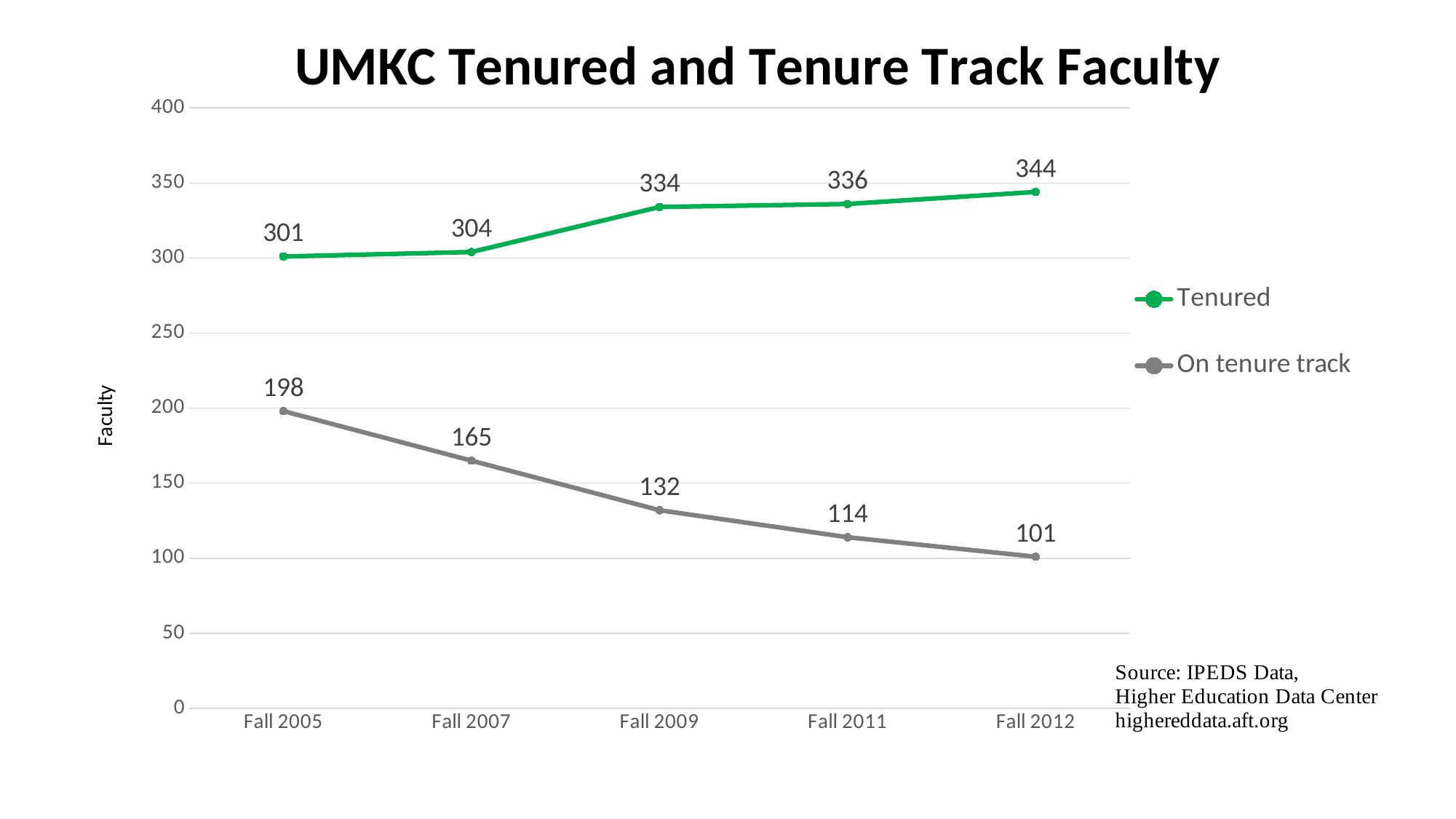
What is the number of Tenured faculty in Fall 2009? 334 Does the On tenure track series rise or fall from Fall 2005 to Fall 2012? Fall What kind of chart is shown on the slide? Line chart What is the difference between Tenured and On tenure track faculty in Fall 2011? 222 How many time periods are shown on the x axis? 5 How many series does the legend list? 2 By how much did the On tenure track count fall from Fall 2005 to Fall 2007? 33 What is the number of faculty On tenure track in Fall 2005? 198 In which period is the On tenure track faculty count lowest? Fall 2012 Which is larger in Fall 2007: the Tenured count or the On tenure track count? Tenured In which period is the Tenured faculty count highest? Fall 2012 What is the number of faculty On tenure track in Fall 2012? 101